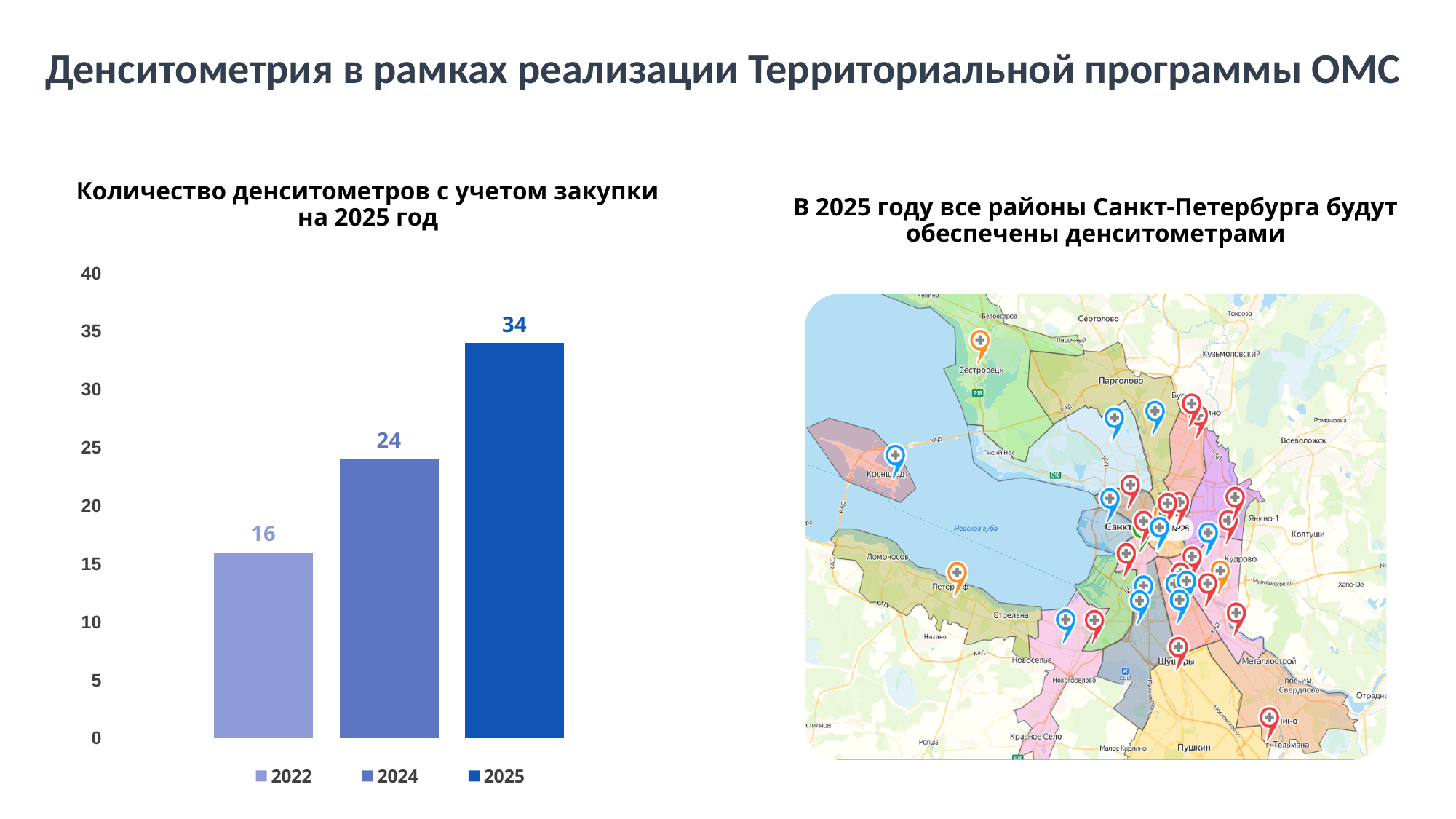
What is the value for 2024 in the chart 'Количество денситометров с учетом закупки на 2025 год'? 24 What is the value for 2022 in the chart 'Количество денситометров с учетом закупки на 2025 год'? 16 What kind of chart is 'Количество денситометров с учетом закупки на 2025 год'? bar chart What is the value for 2025 in the chart 'Количество денситометров с учетом закупки на 2025 год'? 34 In the chart 'Количество денситометров с учетом закупки на 2025 год', is the value for 2025 greater or less than 30? greater Do the values in the chart 'Количество денситометров с учетом закупки на 2025 год' rise or fall from 2022 to 2025? rise Which year has the highest value in the chart 'Количество денситометров с учетом закупки на 2025 год'? 2025 In the chart 'Количество денситометров с учетом закупки на 2025 год', which is larger: the value for 2024 or the value for 2025? 2025 What is the difference between the values for 2024 and 2022 in the chart 'Количество денситометров с учетом закупки на 2025 год'? 8 How many bars are shown in the chart 'Количество денситометров с учетом закупки на 2025 год'? 3 What is the difference between the values for 2025 and 2022 in the chart 'Количество денситометров с учетом закупки на 2025 год'? 18 Which year has the lowest value in the chart 'Количество денситометров с учетом закупки на 2025 год'? 2022